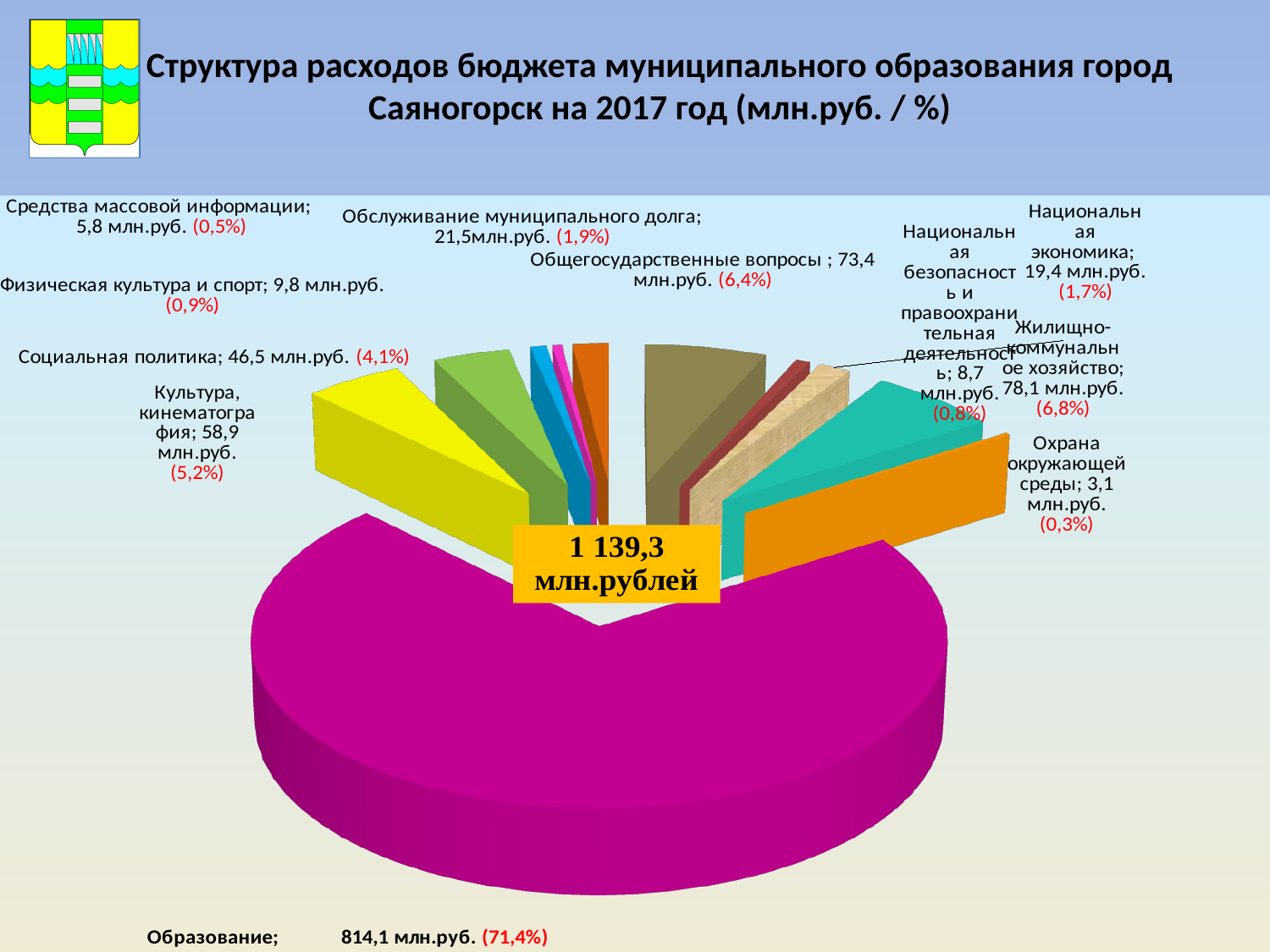
What is the difference between Жилищно-коммунальное хозяйство and Общегосударственные вопросы in млн.руб.? 4,7 млн.руб. What total amount is printed in the centre of the chart? 1 139,3 млн.рублей Which category has the smallest value? Охрана окружающей среды What is the value for Обслуживание муниципального долга? 21,5 млн.руб. Which category has the largest value? Образование What kind of chart is shown on the slide? pie chart What is the value for Жилищно-коммунальное хозяйство? 78,1 млн.руб. How many categories are shown in the pie chart? 11 What is the value for Образование? 814,1 млн.руб. What share of the pie does Общегосударственные вопросы represent? 6,4% Which is larger: Социальная политика or Культура, кинематография? Культура, кинематография What share of the pie does Образование represent? 71,4%